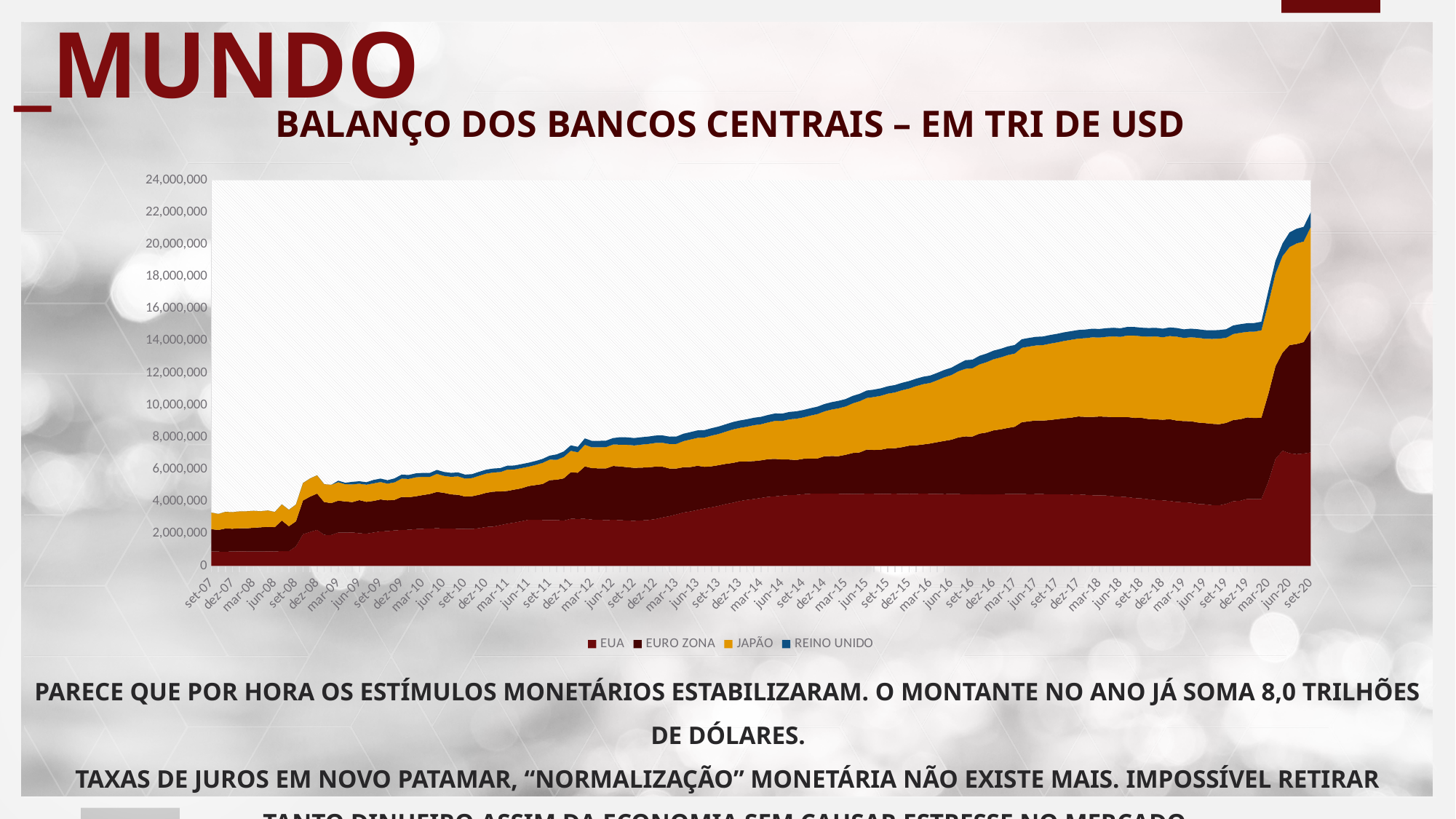
Is the total stacked value at set-20 greater or less than 20,000,000? greater Which series contributes the smallest amount to the stack at set-20? REINO UNIDO Is the total stacked value at set-07 greater or less than 4,000,000? less Is the total stacked value at dez-19 greater or less than 16,000,000? less Which series is shown in blue in the legend? REINO UNIDO Overall, do the stacked values rise or fall from set-07 to set-20? Rise How many series does the legend list? 4 What kind of chart is shown on the slide? Stacked area chart At set-20, is the value for EUA larger or smaller than the value for REINO UNIDO? EUA is larger What is the title of the chart? BALANÇO DOS BANCOS CENTRAIS – EM TRI DE USD